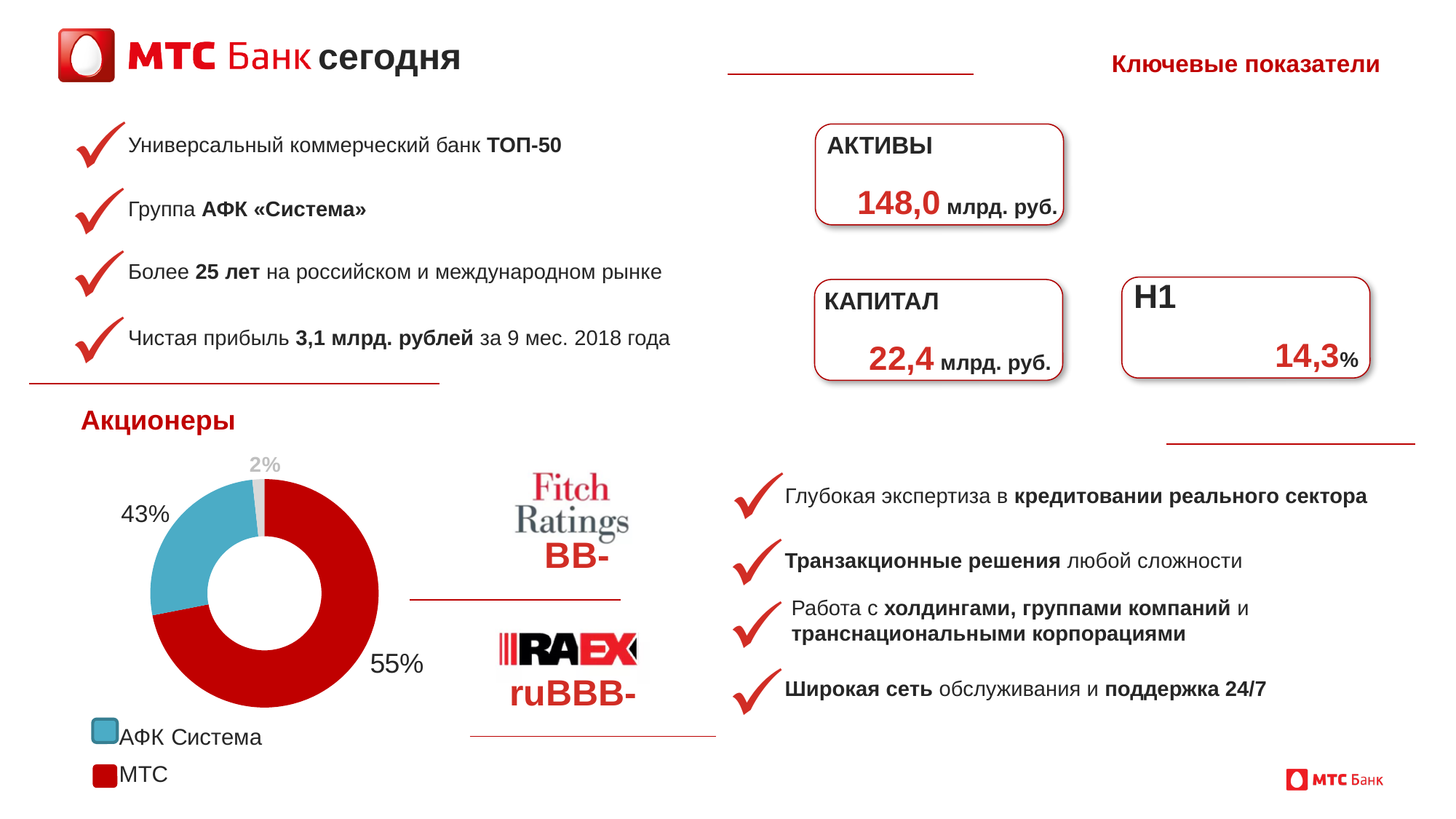
What type of chart is the Акционеры chart? doughnut chart What is the smallest percentage shown on the Акционеры chart? 2% Which is larger in the Акционеры chart, the МТС slice or the АФК Система slice? МТС What is the title of the chart on the slide? Акционеры Which shareholder has the largest slice in the Акционеры chart? МТС What share of the Акционеры chart does МТС hold? 55% What colour is the МТС slice in the Акционеры chart? red How many slices does the Акционеры chart have? 3 How many entries does the legend of the Акционеры chart list? 2 What share of the Акционеры chart does АФК Система hold? 43% What do the three labelled slices of the Акционеры chart add up to? 100% By how many percentage points does the МТС share exceed the АФК Система share in the Акционеры chart? 12%